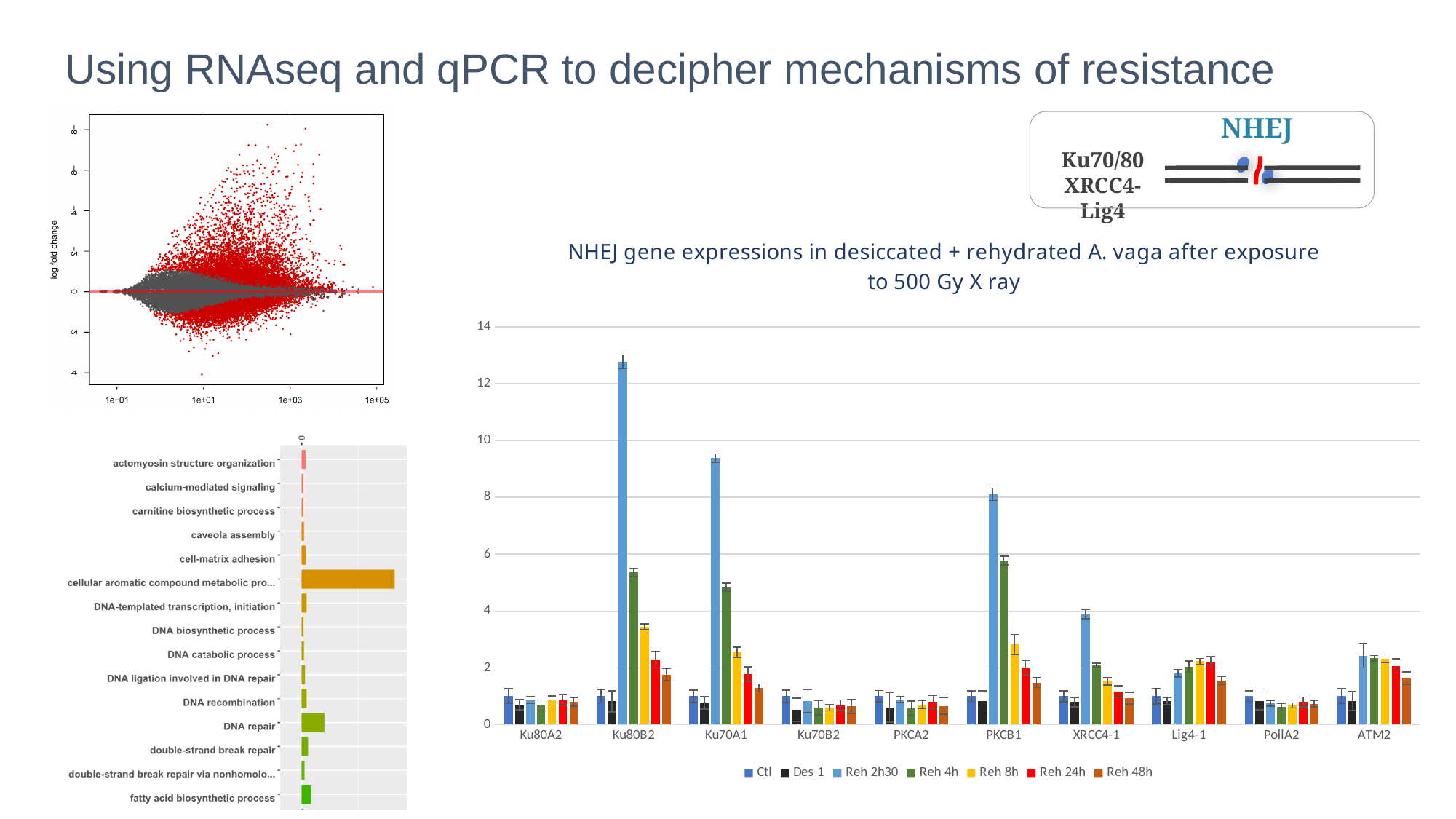
In the NHEJ gene expressions chart, which is larger: the Reh 2h30 value for Ku80B2 or the Reh 2h30 value for Ku70A1? Ku80B2 In the NHEJ gene expressions chart, is the Reh 2h30 value for Ku70A1 greater or less than 8? greater In the NHEJ gene expressions chart, how many series does the legend list? 7 In the NHEJ gene expressions chart, which gene has the highest Reh 2h30 bar? Ku80B2 What kind of chart is the chart on the right titled 'NHEJ gene expressions in desiccated + rehydrated A. vaga after exposure to 500 Gy X ray'? bar chart In the NHEJ gene expressions chart, is the Reh 2h30 value for XRCC4-1 greater or less than 2? greater In the NHEJ gene expressions chart, is the Reh 2h30 value for PKCB1 greater or less than 10? less In the NHEJ gene expressions chart, which is larger for Ku80B2: the Reh 4h value or the Reh 8h value? Reh 4h In the NHEJ gene expressions chart, what is the last entry in the legend? Reh 48h In the NHEJ gene expressions chart, how many gene categories are shown on the x axis? 10 In the horizontal bar chart at the bottom left of the slide, which category has the longest bar? cellular aromatic compound metabolic pro...